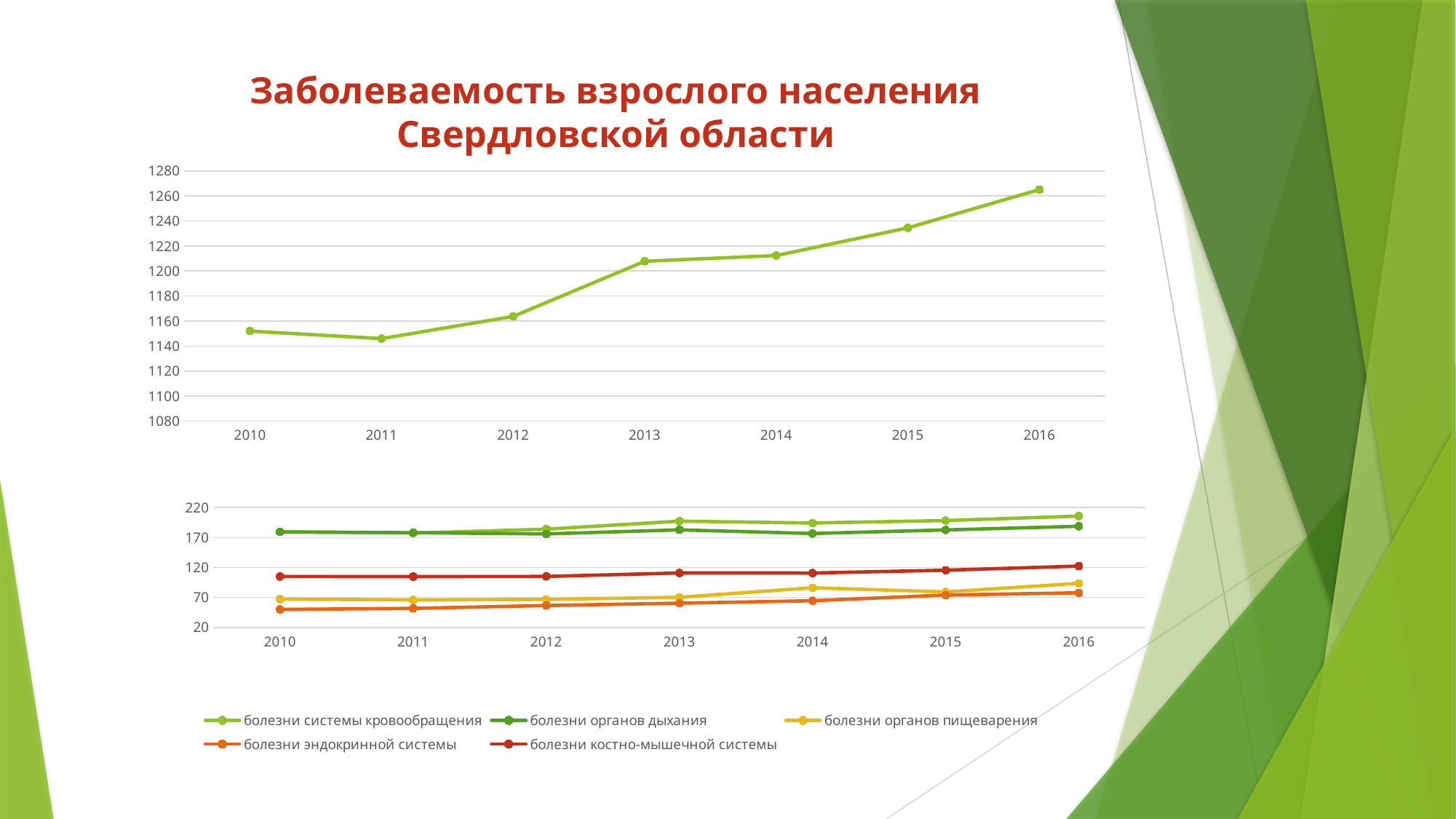
On the top chart, is the value for 2011 greater or less than 1160? less On the top chart, is the value for 2016 greater or less than 1240? greater On the bottom chart, which series has the highest value in 2016? болезни системы кровообращения On the top chart, do the values generally rise or fall from 2010 to 2016? rise On the bottom chart, which series has the lowest value in 2010? болезни эндокринной системы What kind of chart is the top chart on the slide? line chart What is the title of the slide's chart? Заболеваемость взрослого населения Свердловской области On the top chart, which year has the lowest value? 2011 On the bottom chart, is the value for болезни костно-мышечной системы in 2010 greater or less than 120? less On the top chart, which year has the highest value? 2016 How many series does the legend of the bottom chart list? 5 How many data points are plotted on the top chart? 7